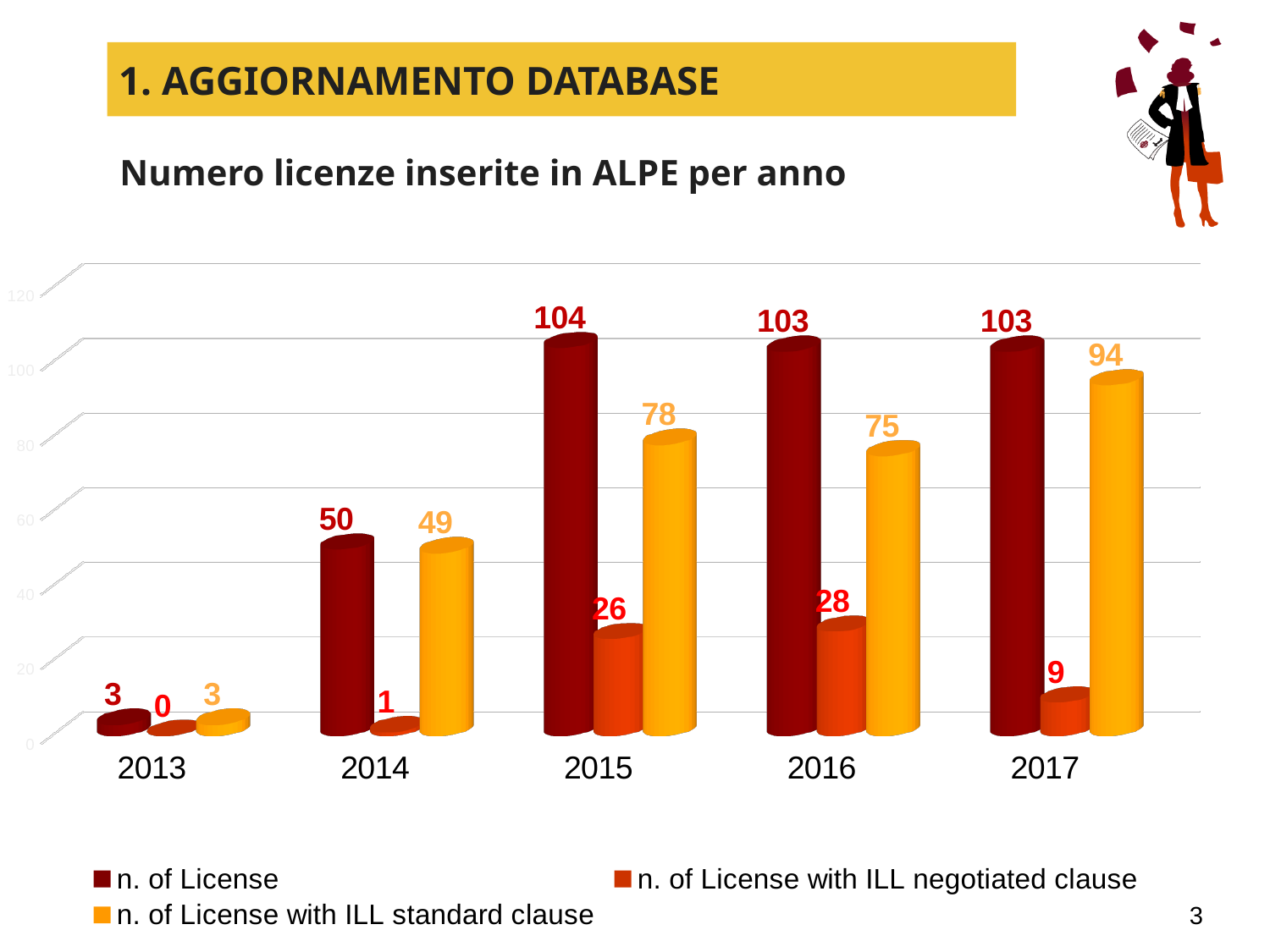
How many series does the legend list? 3 What is the value of n. of License with ILL standard clause for 2017? 94 Which is larger in 2014: n. of License with ILL standard clause or n. of License with ILL negotiated clause? n. of License with ILL standard clause Does n. of License with ILL negotiated clause rise or fall from 2013 to 2016? rise How many years are shown on the x axis? 5 Which year has the lowest value for n. of License with ILL standard clause? 2013 What is the value of n. of License for 2015? 104 Which year has the highest value for n. of License? 2015 What is the value of n. of License with ILL negotiated clause for 2016? 28 What kind of chart is shown on the slide? bar chart What is the title of the chart? Numero licenze inserite in ALPE per anno What is the difference between n. of License and n. of License with ILL standard clause in 2016? 28